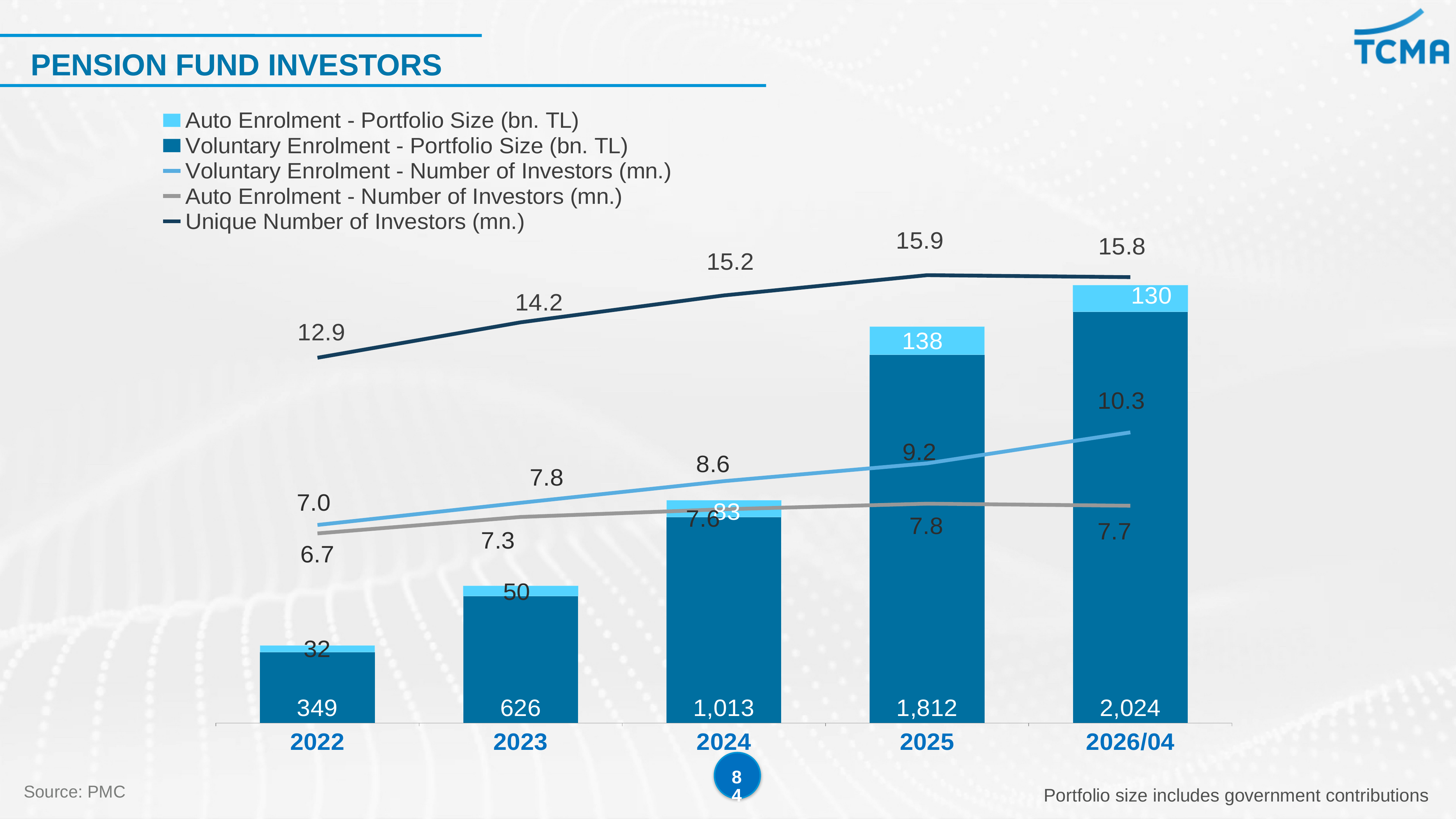
How many years are shown on the x axis? 5 What is the total portfolio size (bn. TL) of the stacked bar for 2025? 1,950 In which year is the Voluntary Enrolment - Portfolio Size (bn. TL) lowest? 2022 Which is larger: the Voluntary Enrolment - Number of Investors (mn.) in 2026/04 or the Auto Enrolment - Number of Investors (mn.) in 2026/04? Voluntary Enrolment - Number of Investors (mn.) What is the Auto Enrolment - Portfolio Size (bn. TL) for 2023? 50 In which year is the Auto Enrolment - Portfolio Size (bn. TL) highest? 2025 How many series does the legend list? 5 What is the difference in Voluntary Enrolment - Portfolio Size (bn. TL) between 2026/04 and 2025? 212 What is the Auto Enrolment - Number of Investors (mn.) in 2026/04? 7.7 Does the Unique Number of Investors (mn.) rise or fall from 2022 to 2025? rise What is the Unique Number of Investors (mn.) in 2024? 15.2 What is the Voluntary Enrolment - Portfolio Size (bn. TL) for 2025? 1,812